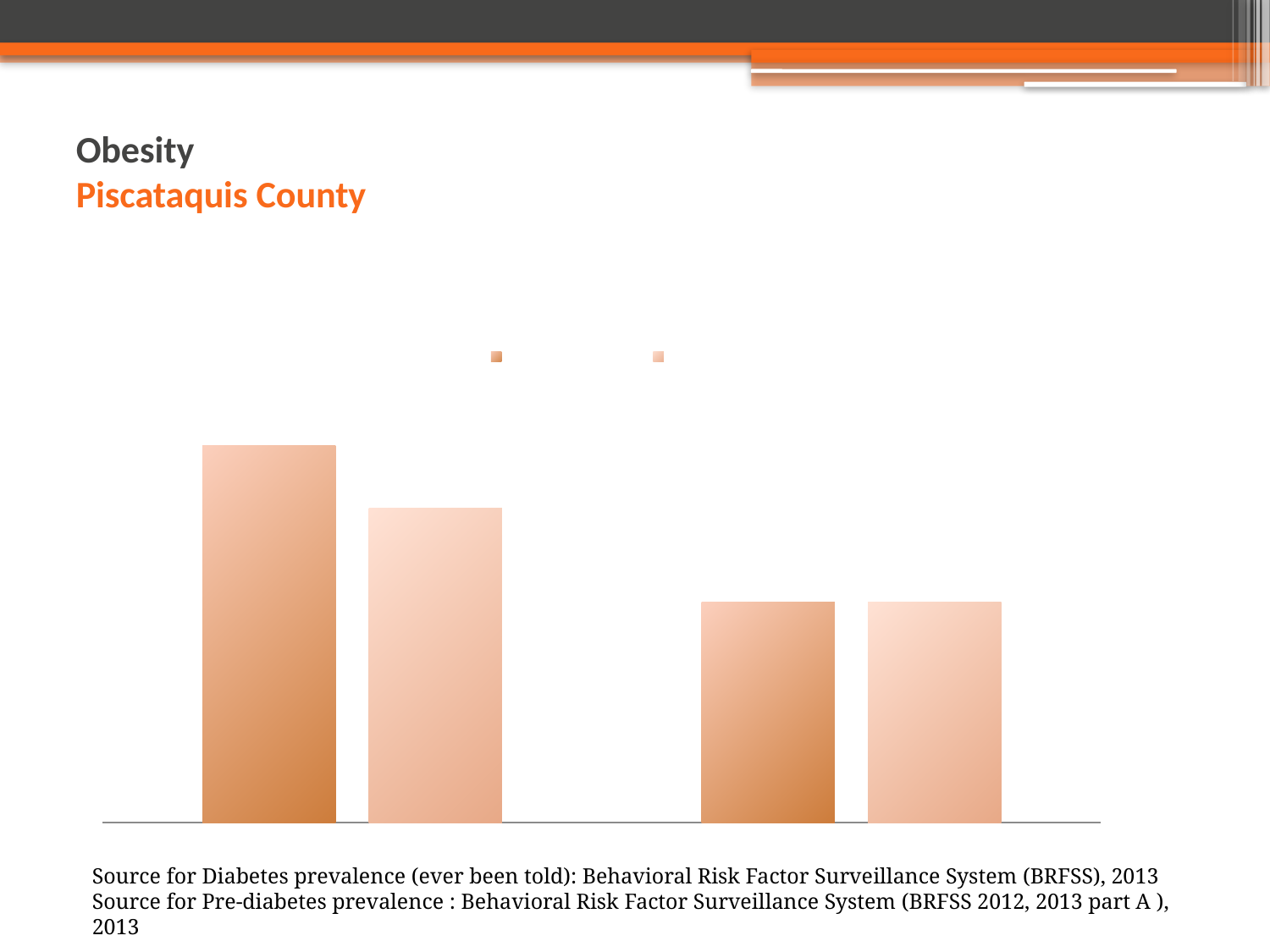
How many groups of bars are shown in the chart? 2 What kind of chart is shown on the slide? bar chart What colour are the bars in the chart? orange How many series does the chart's legend list? 2 Is the leftmost bar in the chart taller or shorter than the rightmost bar? taller Which group of bars is taller, the left pair or the right pair? the left pair How many bars are plotted in the chart? 4 Within the left pair of bars, is the darker orange bar taller or shorter than the lighter bar? taller